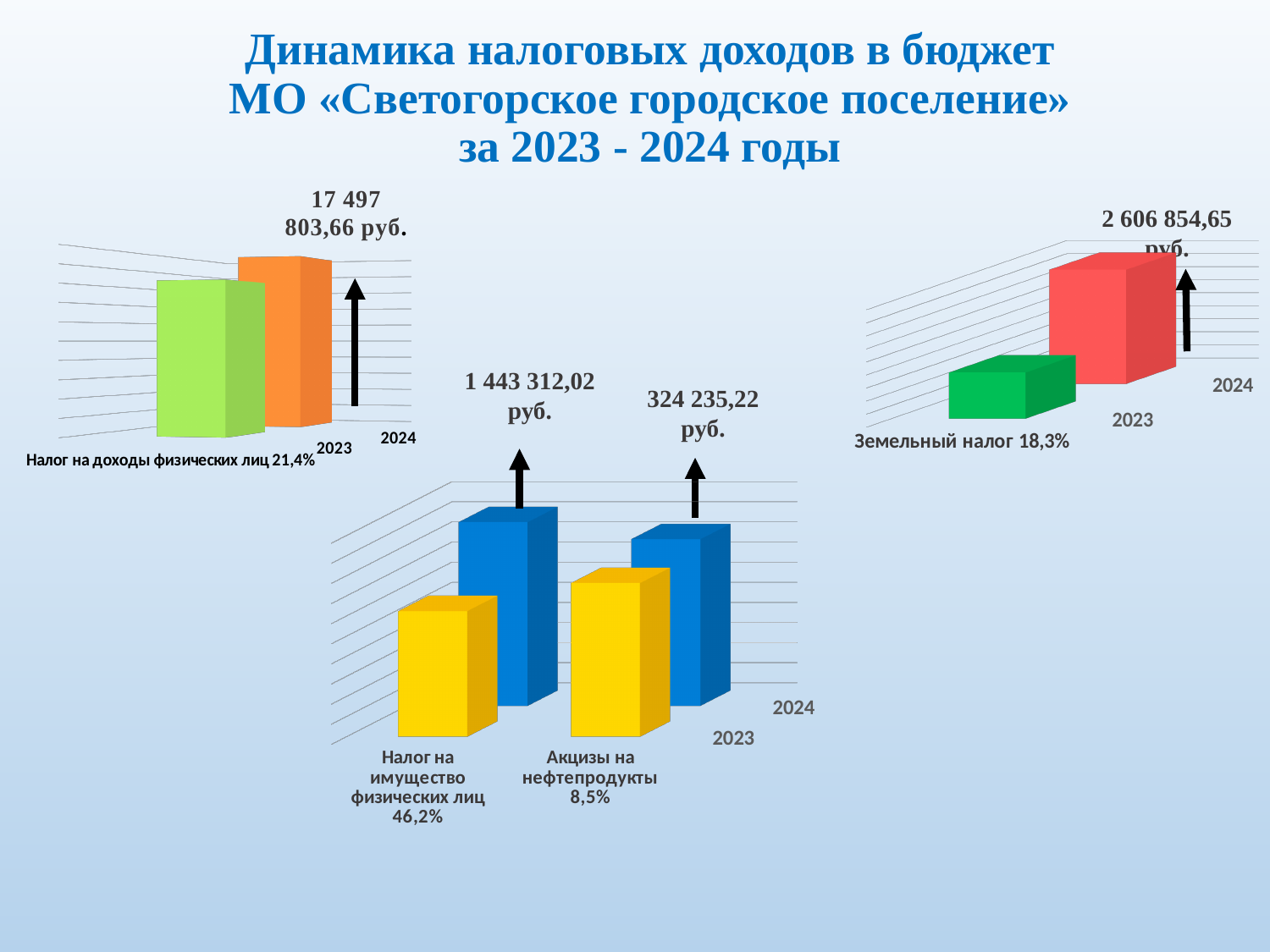
In the right chart («Земельный налог»), does the value rise or fall from 2023 to 2024? rise In the middle chart, which year has the taller bar for «Акцизы на нефтепродукты», 2023 or 2024? 2024 How many categories are shown in the middle chart (the one with «Налог на имущество физических лиц» and «Акцизы на нефтепродукты»)? 2 What percentage is shown in the category label of the left chart, «Налог на доходы физических лиц»? 21,4% What kind of chart is the left chart labelled «Налог на доходы физических лиц 21,4%»? bar chart In the middle chart, which category has the taller 2024 bar, «Налог на имущество физических лиц» or «Акцизы на нефтепродукты»? Налог на имущество физических лиц In the middle chart, what value is printed above the 2024 bar for «Налог на имущество физических лиц»? 1 443 312,02 руб. In the middle chart, what value is printed above the 2024 bar for «Акцизы на нефтепродукты»? 324 235,22 руб. In the left chart («Налог на доходы физических лиц»), which year has the taller bar, 2023 or 2024? 2024 In the right chart («Земельный налог»), what value is printed next to the 2024 bar? 2 606 854,65 руб. In the left chart («Налог на доходы физических лиц»), what value is printed next to the 2024 bar? 17 497 803,66 руб. What percentage is shown in the category label of the right chart, «Земельный налог»? 18,3%